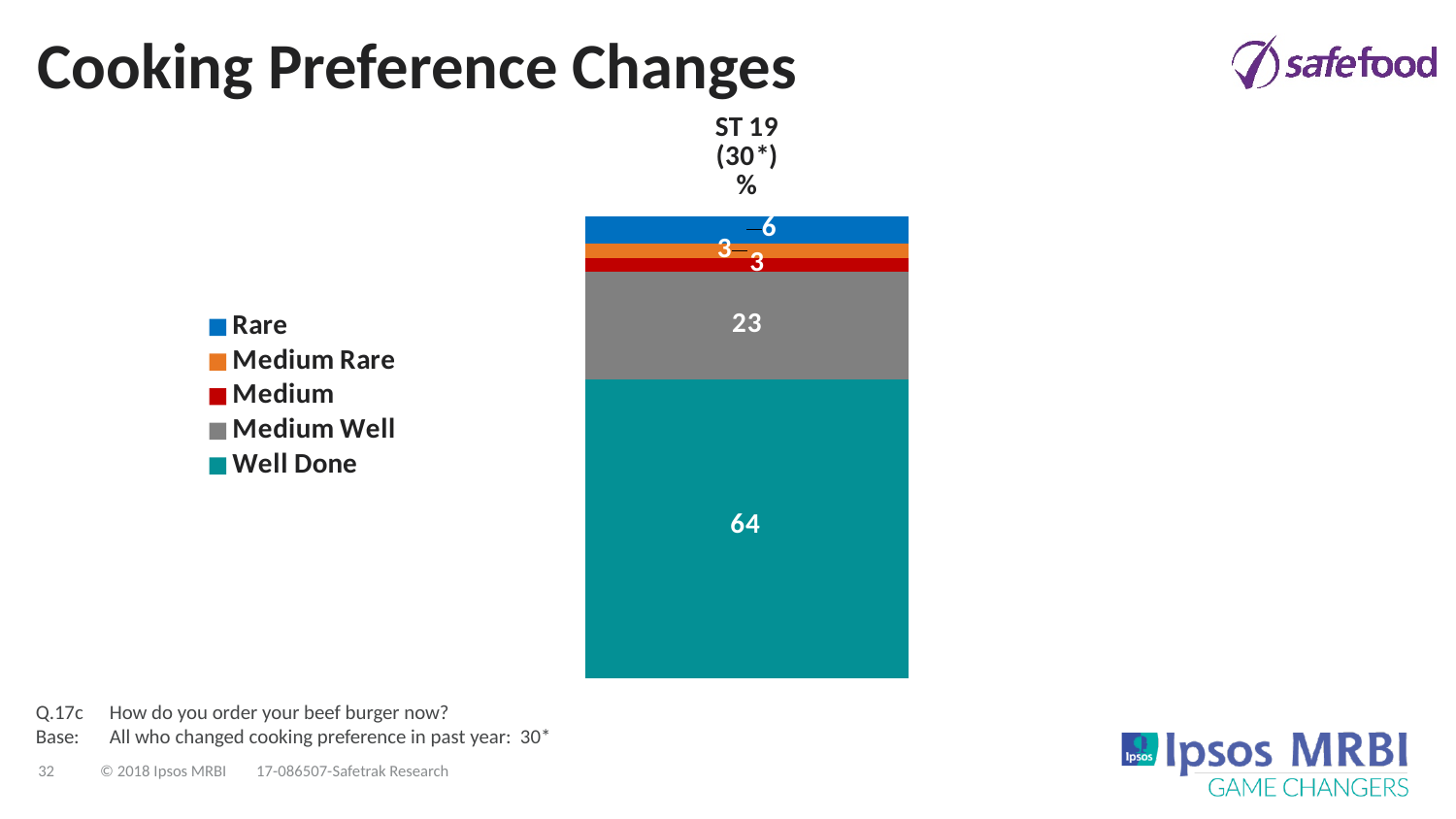
Which is larger, the value for Rare or the value for Medium Well? Medium Well What is the value for Well Done? 64 What is the difference between the Well Done and Medium Well values? 41 What is the value for Medium Rare? 3 How many series does the legend list? 5 Which colour represents Well Done in the legend? Teal What is the value for Medium Well? 23 What is the value for Rare? 6 What is the total of all segments in the stacked bar? 99 What kind of chart is shown on the slide? Stacked bar chart Which cooking preference has the highest value? Well Done What is the label above the stacked bar? ST 19 (30*) %